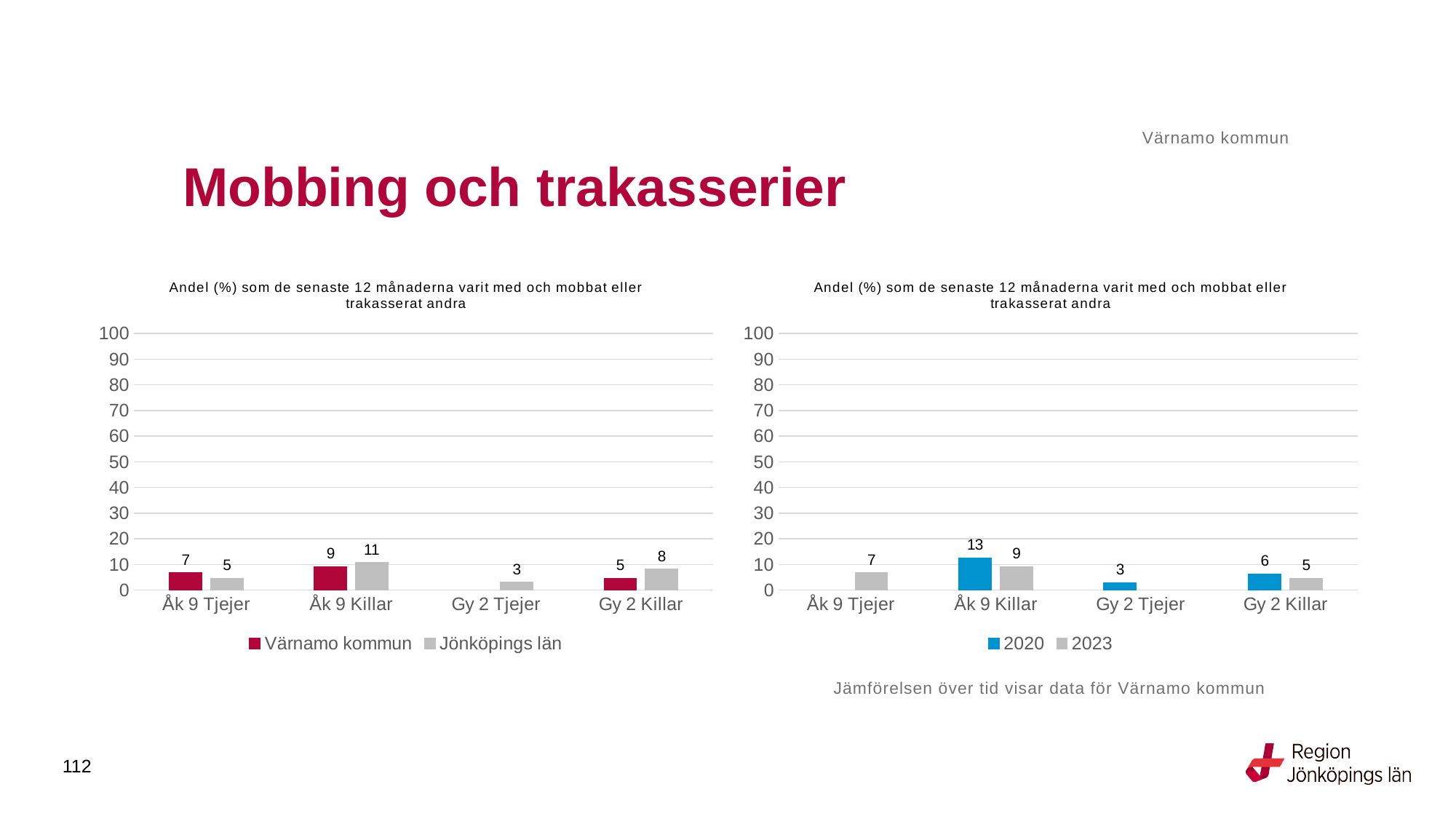
In the right chart, which category has the lowest value for 2023? Gy 2 Killar In the right chart, what is the value for 2023 for Åk 9 Tjejer? 7 In the right chart, how many series does the legend list? 2 What type of chart is the right chart? Bar chart In the left chart, what is the value for Värnamo kommun for Åk 9 Killar? 9 In the left chart, what is the difference between Jönköpings län and Värnamo kommun for Gy 2 Killar? 3 How many categories are shown on the x axis of the left chart? 4 In the left chart, what is the value for Jönköpings län for Gy 2 Killar? 8 In the left chart, which is larger for Åk 9 Tjejer: Värnamo kommun or Jönköpings län? Värnamo kommun In the right chart, what is the difference between 2020 and 2023 for Åk 9 Killar? 4 In the left chart, which category has the highest value for Jönköpings län? Åk 9 Killar In the right chart, what is the value for 2020 for Åk 9 Killar? 13